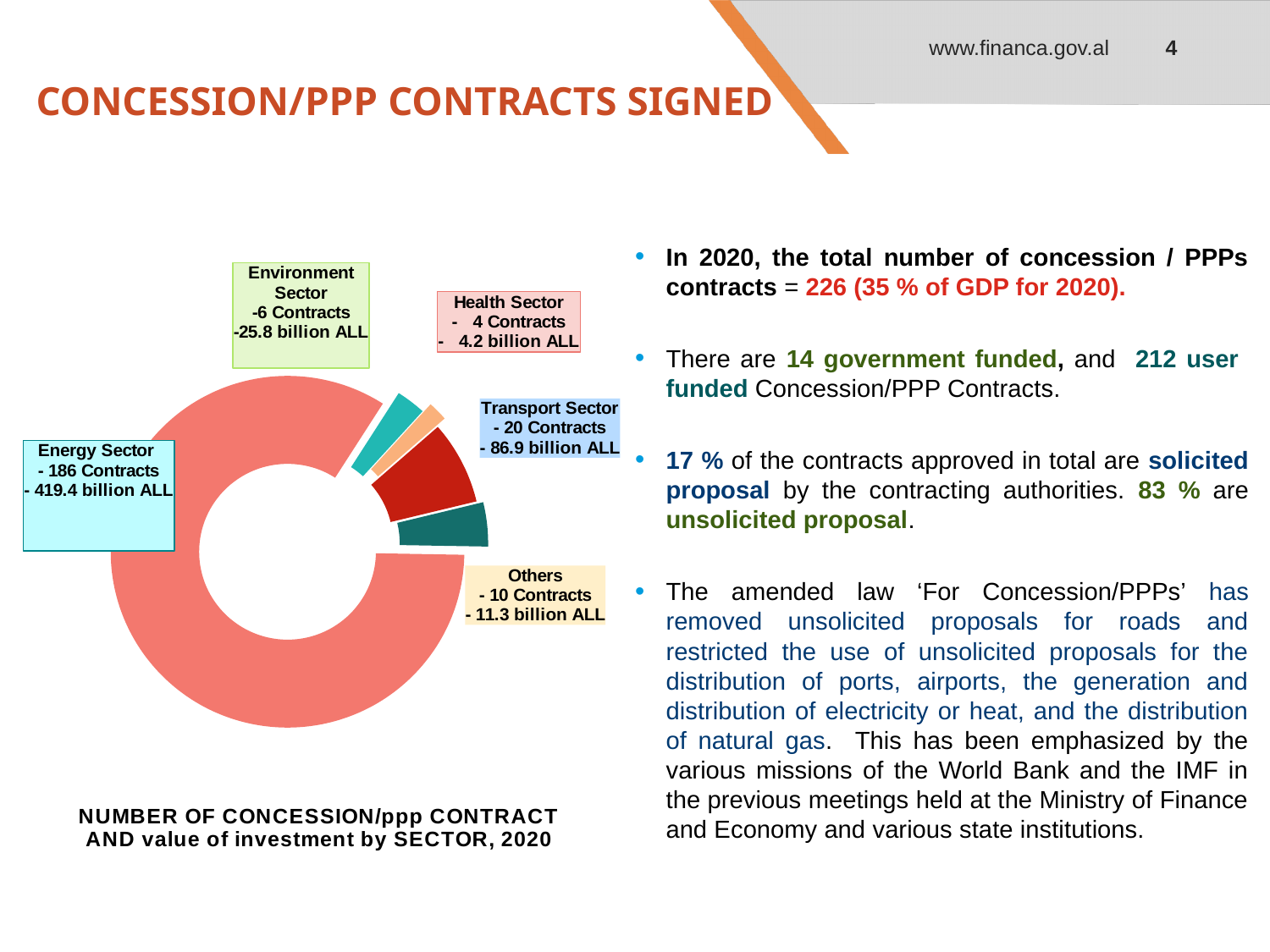
How many sectors are shown in the chart? 5 Which sector has the highest number of contracts in the chart? Energy Sector Which sector has the lowest number of contracts in the chart? Health Sector Which has more contracts, the Transport Sector or Others? Transport Sector What is the total number of contracts across all sectors in the chart? 226 What is the difference in investment value between the Energy Sector and the Transport Sector? 332.5 billion ALL What is the value of investment for the Transport Sector shown in the chart? 86.9 billion ALL How many contracts are shown for the Health Sector? 4 Contracts What is the investment value for the Environment Sector in the chart? 25.8 billion ALL What type of chart is used on the slide? Doughnut chart How many more contracts does the Energy Sector have than the Transport Sector? 166 How many contracts does the Energy Sector have in the pie chart? 186 Contracts